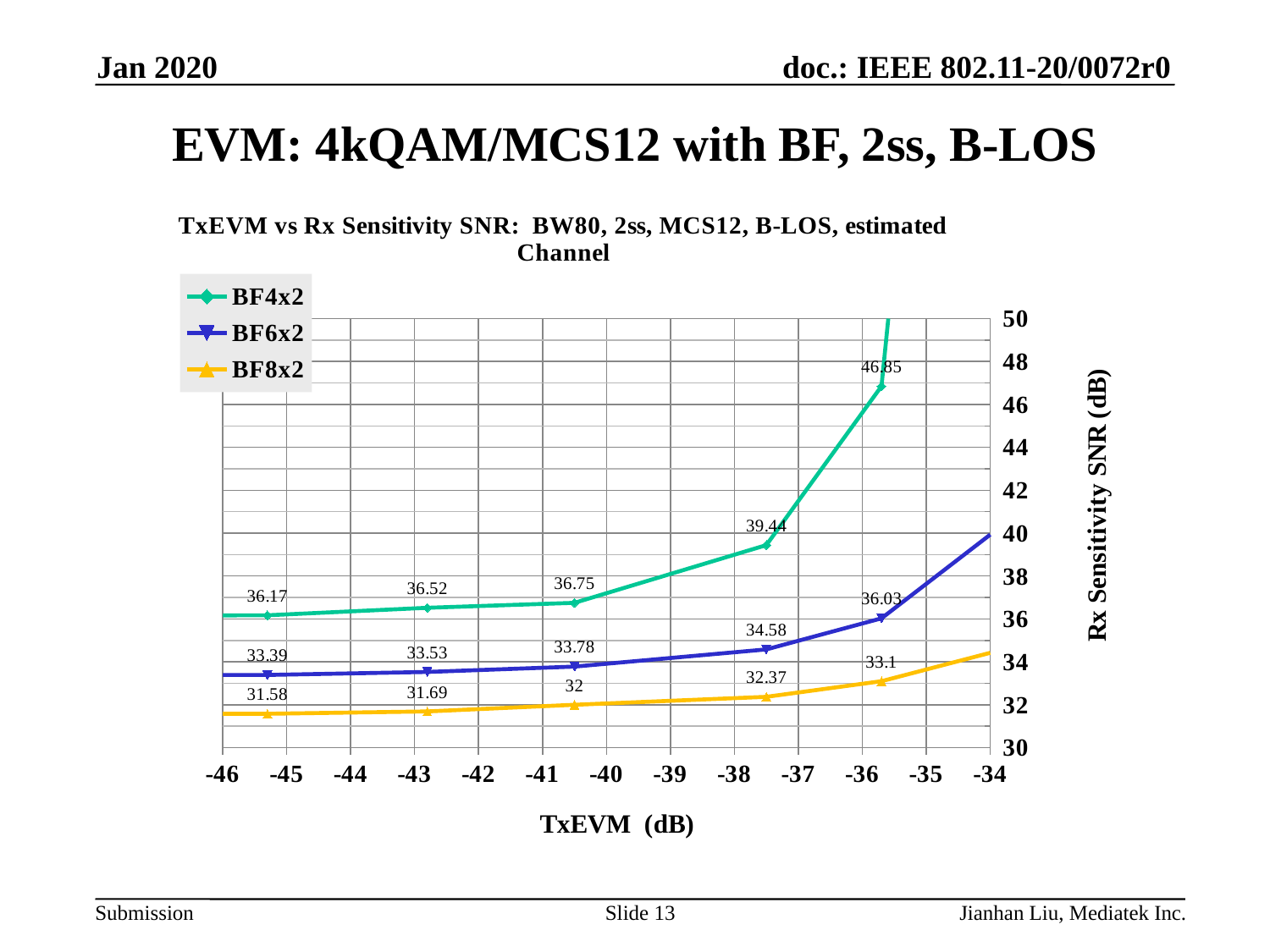
What is the leftmost labeled value of the BF8x2 series? 31.58 Is the value of the BF6x2 series at TxEVM -34 dB greater or less than 38? greater What type of chart is shown on the slide? line chart What is the difference between the rightmost labeled values of BF6x2 (36.03) and BF8x2 (33.1)? 2.93 What is the title of the y axis? Rx Sensitivity SNR (dB) What is the leftmost labeled value of the BF4x2 series? 36.17 What is the highest labeled value of the BF4x2 series? 46.85 As TxEVM increases from -46 dB to -34 dB, do the Rx Sensitivity SNR values rise or fall? rise How many series does the legend list? 3 What is the rightmost labeled value of the BF6x2 series? 36.03 What is the difference between the leftmost labeled values of BF4x2 (36.17) and BF6x2 (33.39)? 2.78 Which series has higher Rx Sensitivity SNR values across the chart, BF4x2 or BF8x2? BF4x2